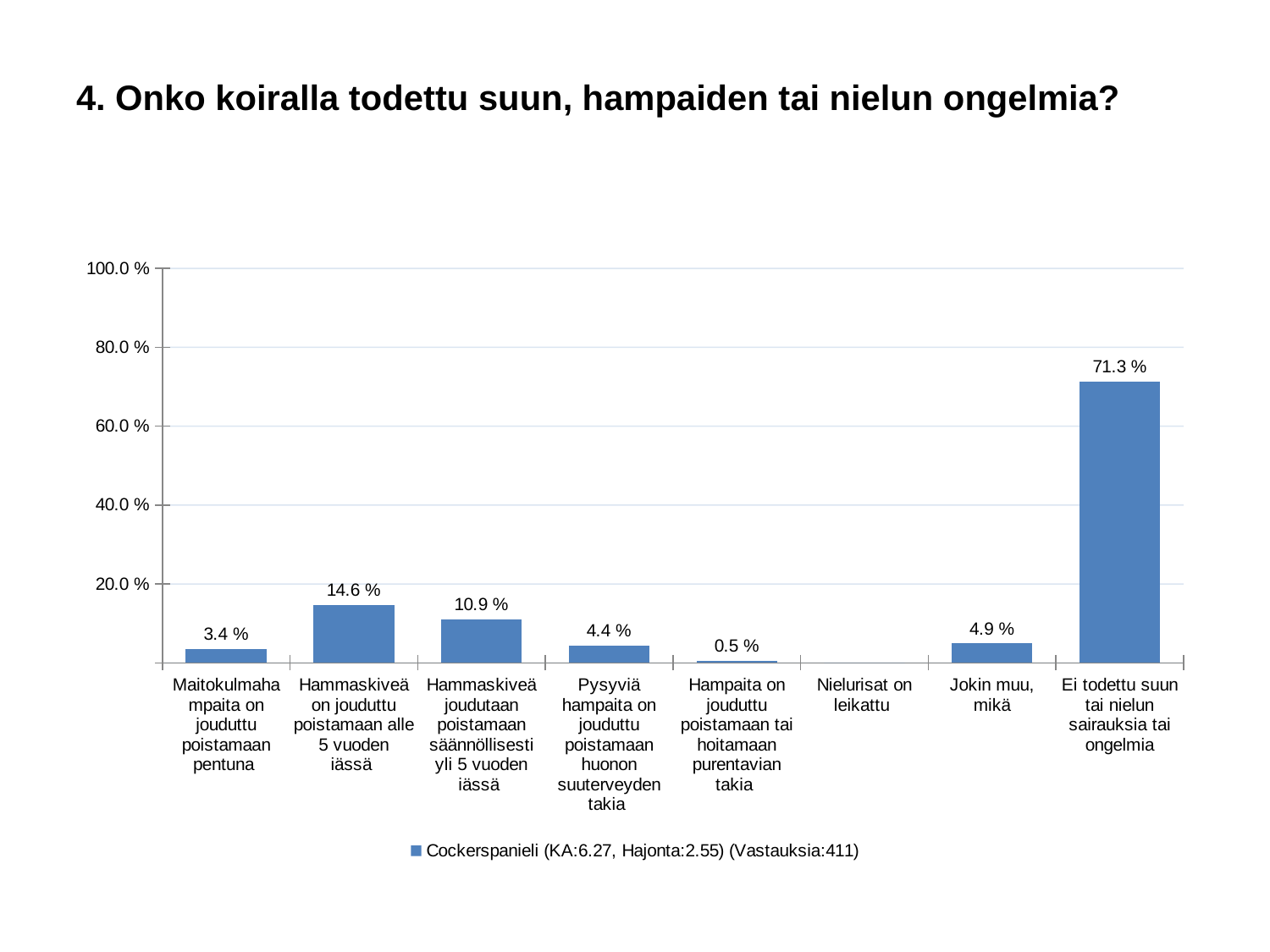
Which is larger: the value for "Maitokulmahampaita on jouduttu poistamaan pentuna" or for "Pysyviä hampaita on jouduttu poistamaan huonon suuterveyden takia"? Pysyviä hampaita on jouduttu poistamaan huonon suuterveyden takia What is the legend entry for the series? Cockerspanieli (KA:6.27, Hajonta:2.55) (Vastauksia:411) What kind of chart is shown on the slide? bar chart How many categories are shown on the x axis? 8 Is the value for "Ei todettu suun tai nielun sairauksia tai ongelmia" greater or less than 60.0 %? greater What is the value for "Hampaita on jouduttu poistamaan tai hoitamaan purentavian takia"? 0.5 % What is the value for "Ei todettu suun tai nielun sairauksia tai ongelmia"? 71.3 % What is the difference between the values for "Hammaskiveä on jouduttu poistamaan alle 5 vuoden iässä" and "Hammaskiveä joudutaan poistamaan säännöllisesti yli 5 vuoden iässä"? 3.7 % What is the value for "Hammaskiveä on jouduttu poistamaan alle 5 vuoden iässä"? 14.6 % What is the value for "Jokin muu, mikä"? 4.9 % Which labelled category has the lowest value? Hampaita on jouduttu poistamaan tai hoitamaan purentavian takia Which category has the highest value? Ei todettu suun tai nielun sairauksia tai ongelmia